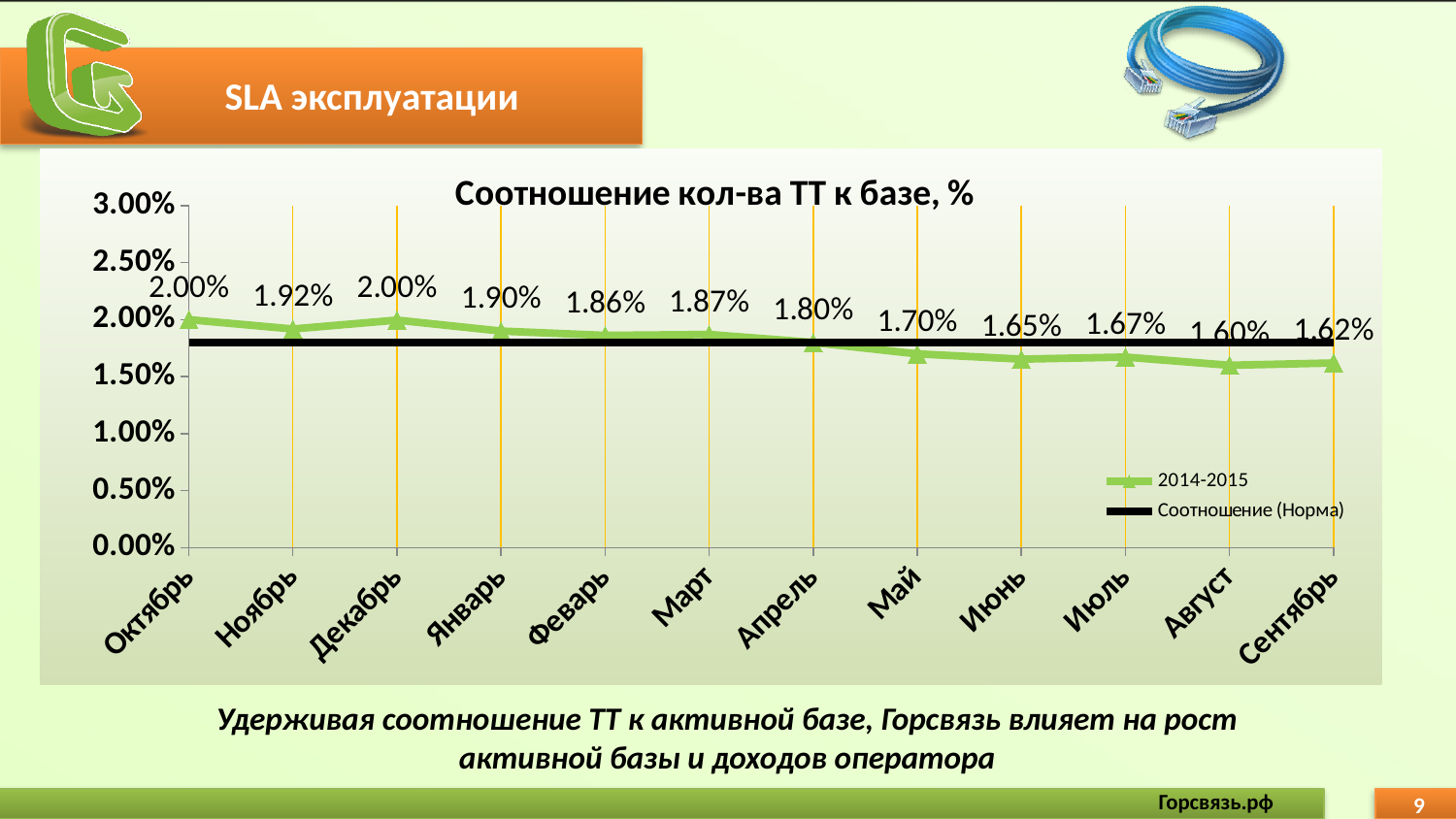
Is the value of the Соотношение (Норма) line greater or less than 2.00%? less What is the value for Сентябрь in the 2014-2015 series? 1.62% How many series does the legend list? 2 What kind of chart is shown on the slide? line chart What is the value for Октябрь in the 2014-2015 series? 2.00% Which is larger, the value for Июнь or the value for Июль? Июль Which month has the lowest value in the 2014-2015 series? Август What is the value for Февраль in the 2014-2015 series? 1.86% How many months are shown on the x axis? 12 What is the value for Май in the 2014-2015 series? 1.70% What is the difference between the values for Октябрь and Сентябрь in the 2014-2015 series? 0.38% Do the values of the 2014-2015 series generally rise or fall from Октябрь to Сентябрь? fall